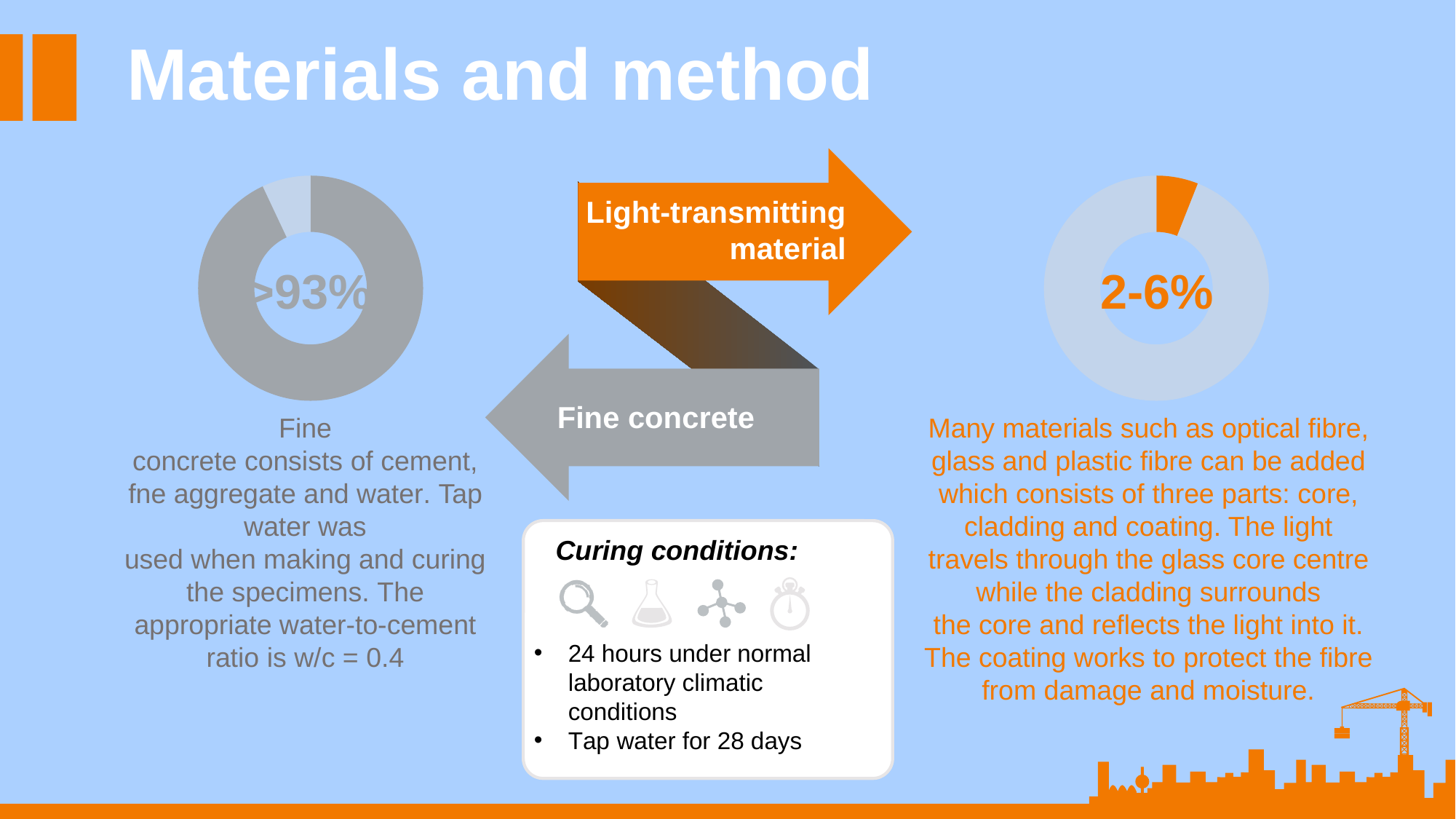
What kind of chart is the left chart on the slide? Donut chart How many slices does the left donut chart have? 2 What value is printed in the centre of the left donut chart? >93% What kind of chart is the right chart on the slide? Donut chart Which is larger: the share shown in the left donut chart (fine concrete) or the share shown in the right donut chart (light-transmitting material)? Fine concrete (left chart) What colour is the large slice in the left donut chart? Grey According to the left donut chart, what share of the material is fine concrete? >93% Is the share shown in the right donut chart greater or less than 50%? less What colour is the highlighted slice in the right donut chart? Orange How many slices does the right donut chart have? 2 According to the right donut chart, what share of the material is light-transmitting material? 2-6% What value is printed in the centre of the right donut chart? 2-6%